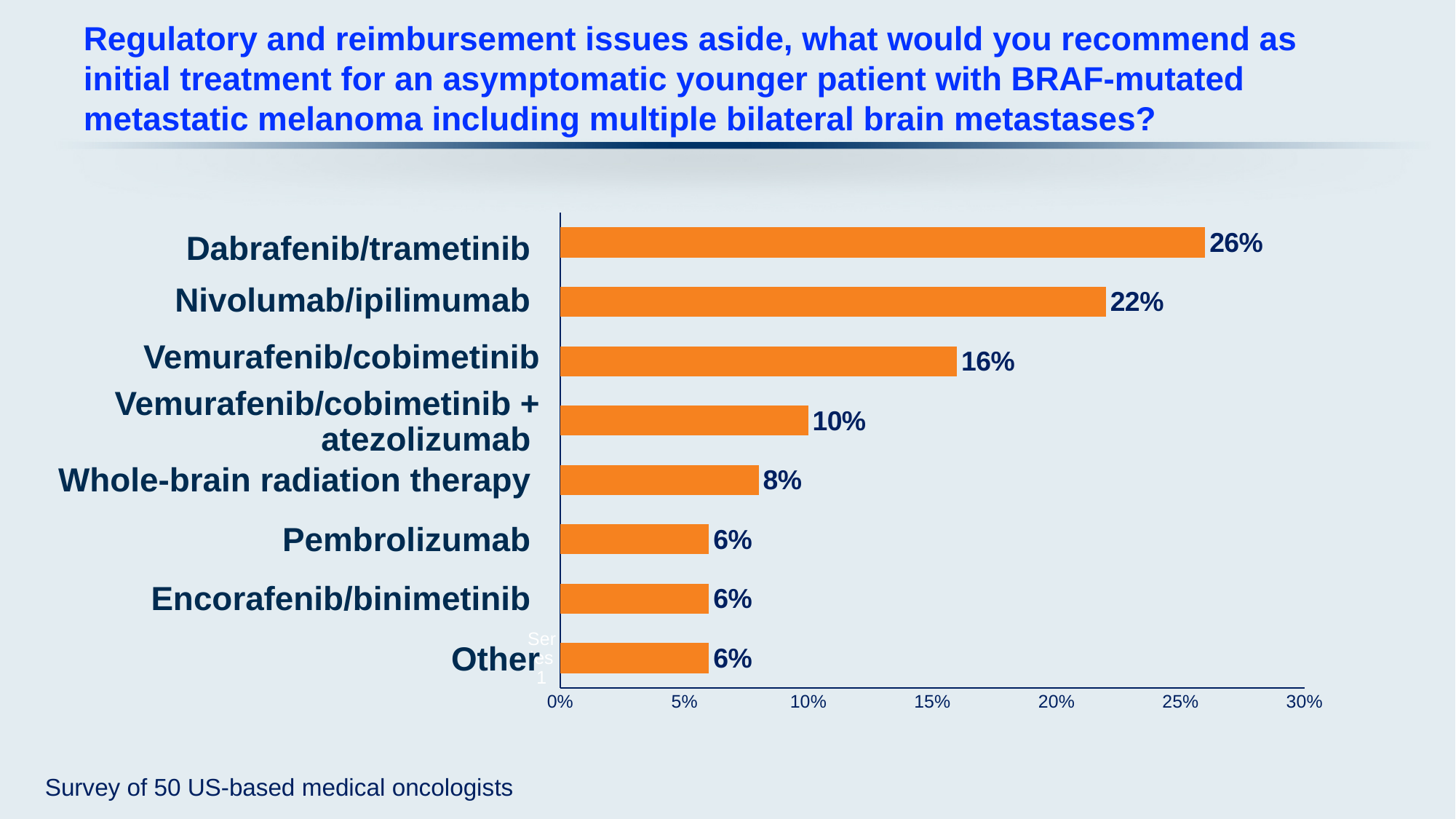
What is the value shown for Whole-brain radiation therapy? 8% What kind of chart is shown on the slide? Bar chart Is the value for Nivolumab/ipilimumab greater or less than 20%? greater What is the difference in percentage points between Dabrafenib/trametinib and Nivolumab/ipilimumab? 4% What percentage of respondents recommended Nivolumab/ipilimumab? 22% How many treatment options are shown in the chart? 8 Which is larger, the value for Vemurafenib/cobimetinib or the value for Whole-brain radiation therapy? Vemurafenib/cobimetinib What is the value shown for Vemurafenib/cobimetinib + atezolizumab? 10% How many respondents were surveyed according to the note at the bottom of the slide? 50 US-based medical oncologists Which treatment option has the highest percentage? Dabrafenib/trametinib What is the difference between Vemurafenib/cobimetinib and Vemurafenib/cobimetinib + atezolizumab? 6% What percentage of respondents recommended Dabrafenib/trametinib? 26%